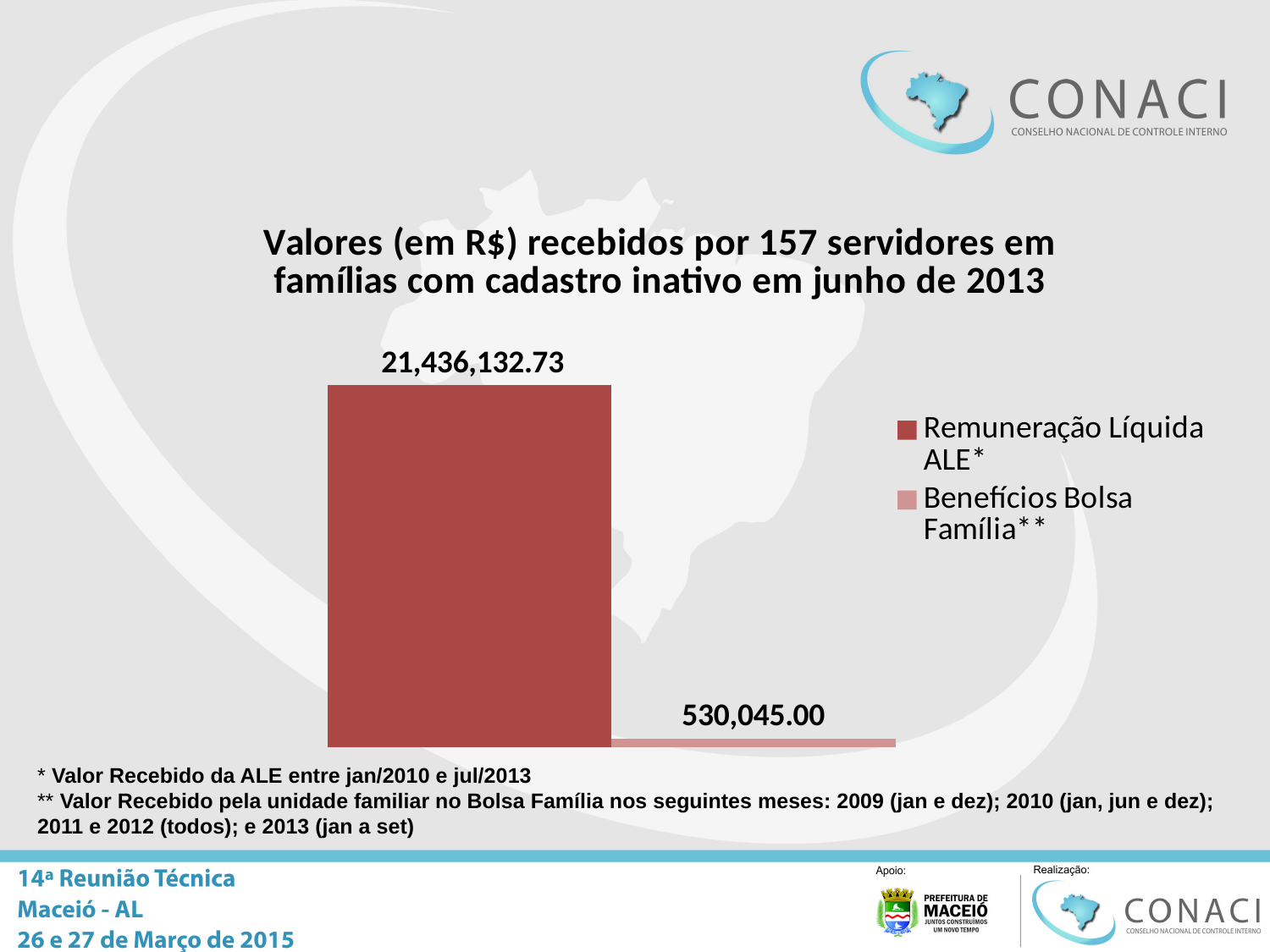
What is the title of the chart? Valores (em R$) recebidos por 157 servidores em famílias com cadastro inativo em junho de 2013 What is the difference between the value for Remuneração Líquida ALE* and the value for Benefícios Bolsa Família**? 20,906,087.73 How many series does the legend list? 2 What value is shown for Benefícios Bolsa Família**? 530,045.00 Which legend entry is shown in the darker red colour? Remuneração Líquida ALE* What is the sum of the two values plotted in the chart? 21,966,177.73 What value is shown for Remuneração Líquida ALE*? 21,436,132.73 Which series has the highest value? Remuneração Líquida ALE* What kind of chart is shown on the slide? Bar chart Which is larger: the value for Remuneração Líquida ALE* or the value for Benefícios Bolsa Família**? Remuneração Líquida ALE* How many bars are plotted in the chart? 2 Which series has the lowest value? Benefícios Bolsa Família**